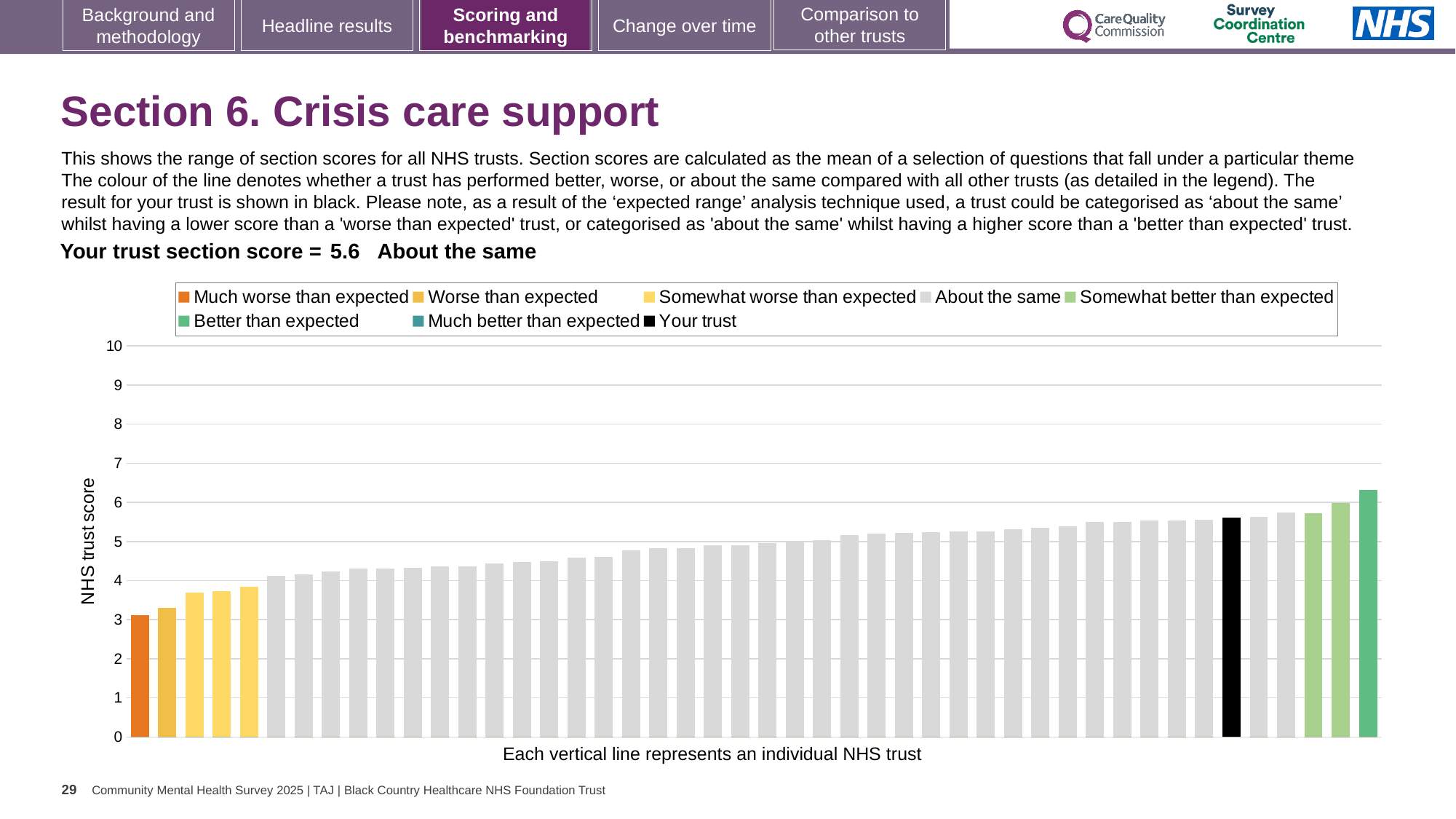
What kind of chart is shown on the slide? Bar chart Is the value of the black 'Your trust' bar greater or less than 5? greater Is the value of the tallest bar on the chart greater or less than 6? greater What is the label on the vertical axis of the chart? NHS trust score What is the section score for your trust shown on the slide? 5.6 Do the bar values rise or fall from left to right along the x axis? Rise What colour is used for the 'Your trust' bar in the chart? Black Which legend category does the highest bar on the chart belong to? Better than expected How many entries does the chart legend list? 8 Which category is your trust's section score placed in? About the same Which legend category does the lowest bar on the chart belong to? Much worse than expected Is the value of the orange 'Much worse than expected' bar greater or less than 4? less